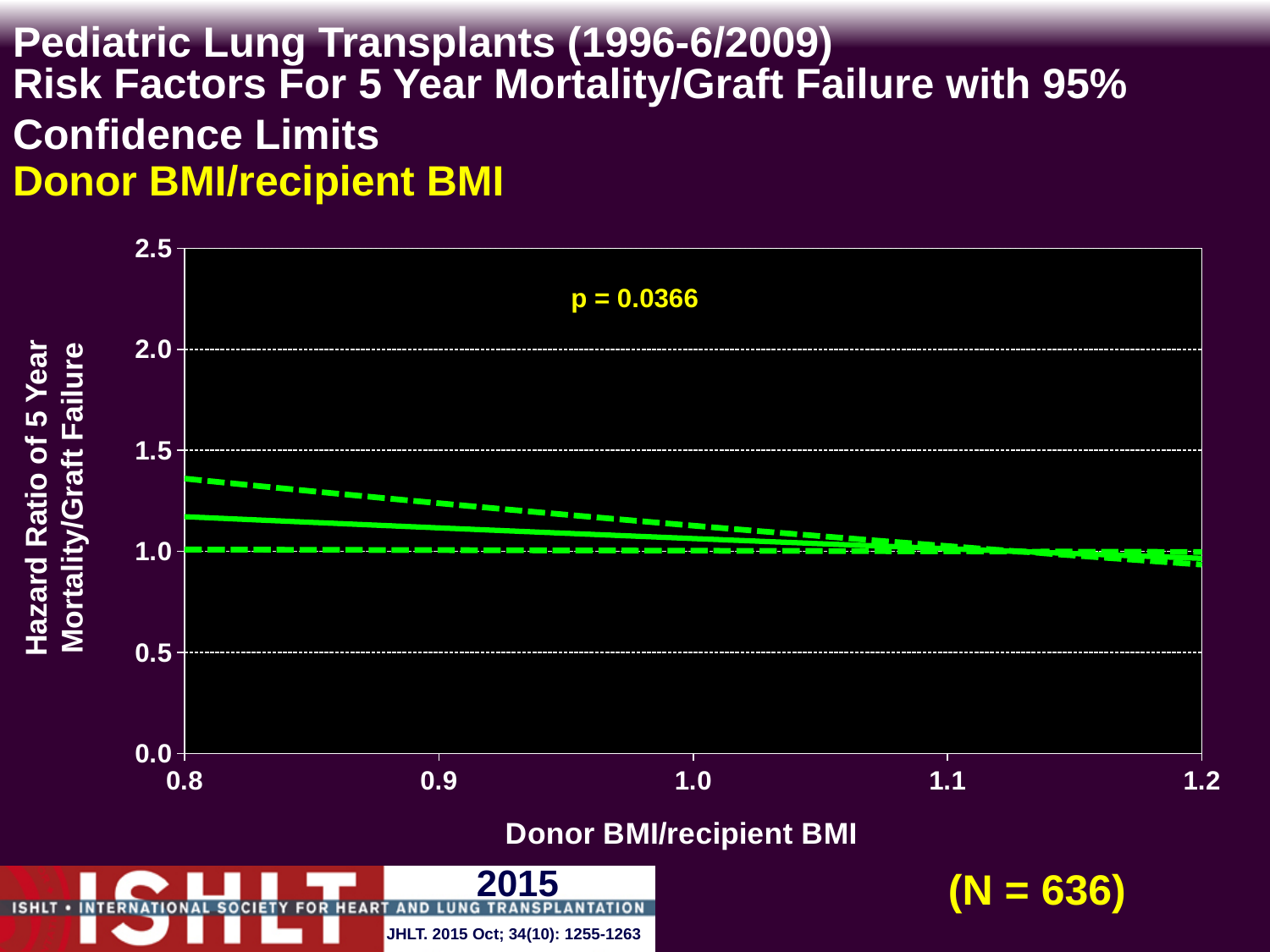
Is the hazard ratio on the solid line at a Donor BMI/recipient BMI of 0.8 greater or less than 1.5? less How many lines are plotted on the chart? 3 Does the solid hazard ratio line rise or fall as Donor BMI/recipient BMI increases from 0.8 to 1.2? fall What is the highest value shown on the y axis of the chart? 2.5 Is the upper dashed confidence limit at a Donor BMI/recipient BMI of 0.8 greater or less than 1.0? greater What p-value is printed on the chart? p = 0.0366 Is the hazard ratio on the solid line at a Donor BMI/recipient BMI of 1.0 greater or less than 1.5? less What kind of chart is shown on the slide? line chart Is the solid line's hazard ratio higher at a Donor BMI/recipient BMI of 0.8 or at 1.2? 0.8